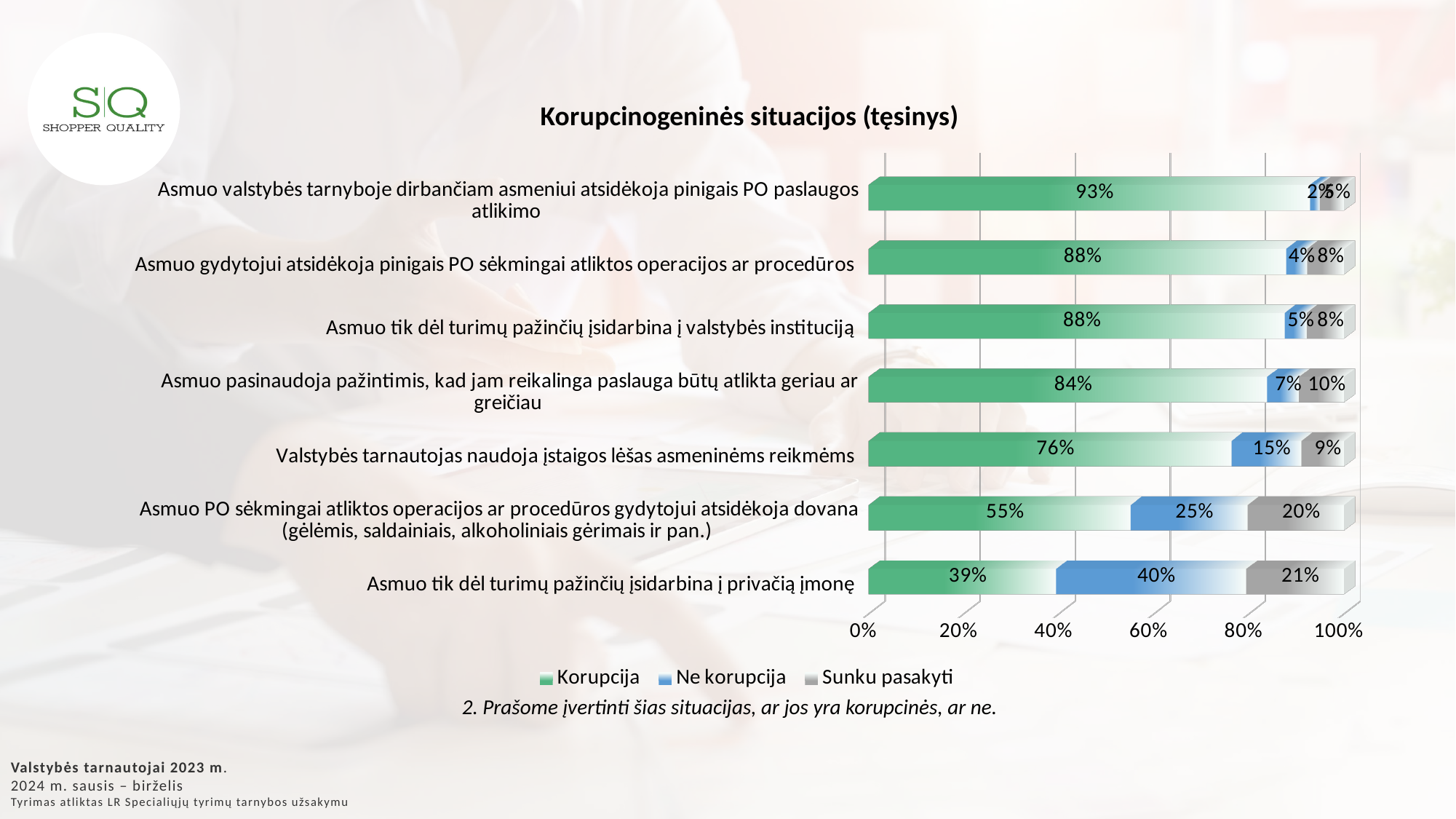
Which is larger for 'Asmuo tik dėl turimų pažinčių įsidarbina į privačią įmonę': the 'Korupcija' value or the 'Ne korupcija' value? Ne korupcija What is the 'Ne korupcija' value for 'Asmuo pasinaudoja pažintimis, kad jam reikalinga paslauga būtų atlikta geriau ar greičiau'? 7% What is the 'Ne korupcija' value for 'Valstybės tarnautojas naudoja įstaigos lėšas asmeninėms reikmėms'? 15% How many series does the legend list? 3 Which situation has the highest 'Korupcija' value? Asmuo valstybės tarnyboje dirbančiam asmeniui atsidėkoja pinigais PO paslaugos atlikimo How many categories (situations) are plotted in the chart? 7 What is the difference between the 'Korupcija' values for 'Asmuo pasinaudoja pažintimis, kad jam reikalinga paslauga būtų atlikta geriau ar greičiau' and 'Valstybės tarnautojas naudoja įstaigos lėšas asmeninėms reikmėms'? 8% What is the 'Sunku pasakyti' value for 'Asmuo PO sėkmingai atliktos operacijos ar procedūros gydytojui atsidėkoja dovana (gėlėmis, saldainiais, alkoholiniais gėrimais ir pan.)'? 20% Which situation has the lowest 'Korupcija' value? Asmuo tik dėl turimų pažinčių įsidarbina į privačią įmonę What type of chart is shown on the slide? stacked bar chart What is the title of the chart? Korupcinogeninės situacijos (tęsinys) What is the 'Korupcija' value for 'Asmuo tik dėl turimų pažinčių įsidarbina į privačią įmonę'? 39%